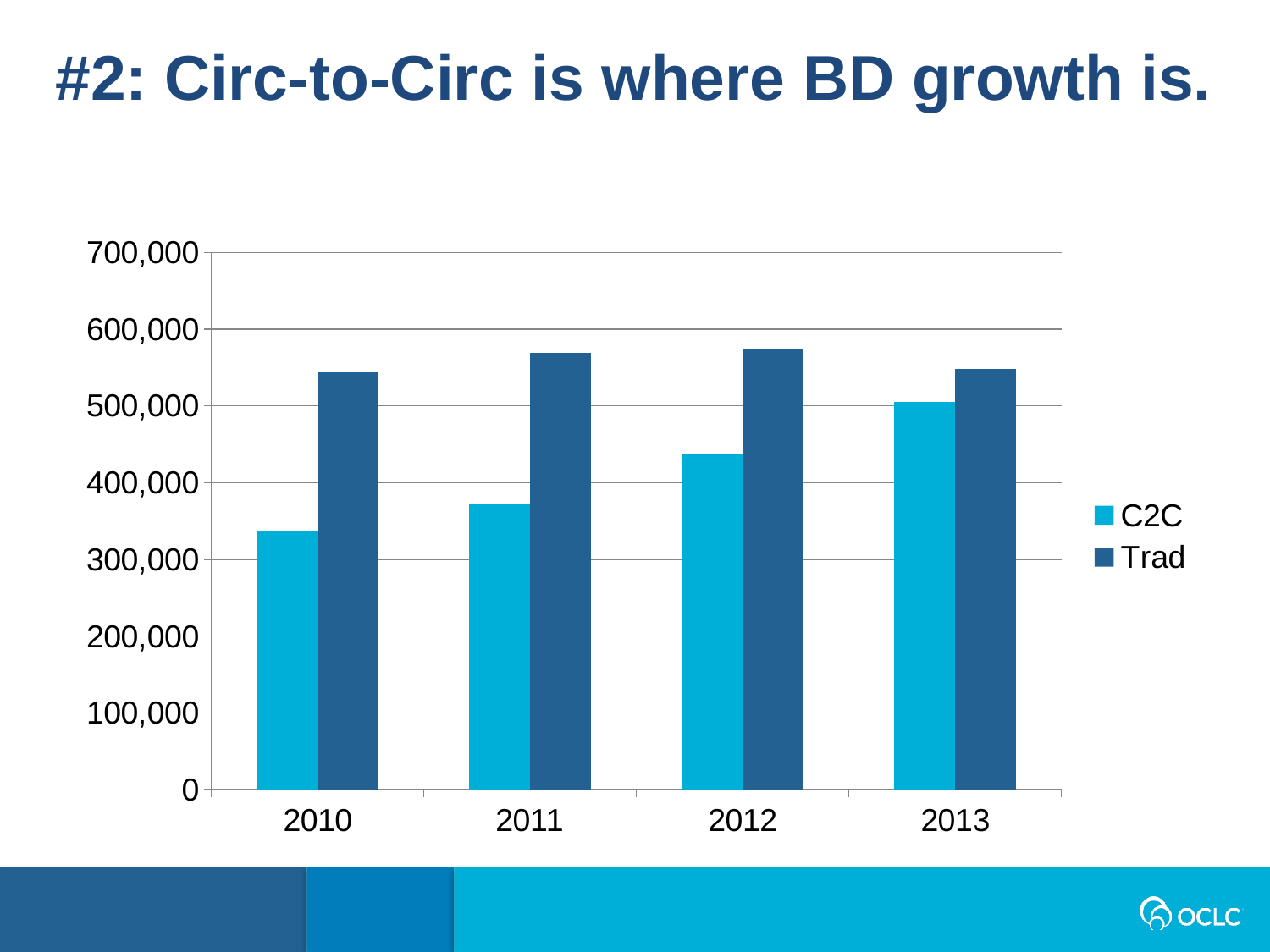
How many years are shown on the x axis of the chart? 4 In 2010, which series has the larger value, C2C or Trad? Trad How many series does the chart's legend list? 2 Is the C2C value for 2010 greater or less than 400,000? less What is the title of the slide containing the chart? #2: Circ-to-Circ is where BD growth is. What are the two series named in the chart's legend? C2C and Trad Is the Trad value for 2011 greater or less than 600,000? less Do the C2C values rise or fall from 2010 to 2013? rise What kind of chart is shown on the slide? bar chart In which year is the C2C value lowest? 2010 Is the Trad value for 2012 greater or less than 500,000? greater In which year is the C2C value highest? 2013